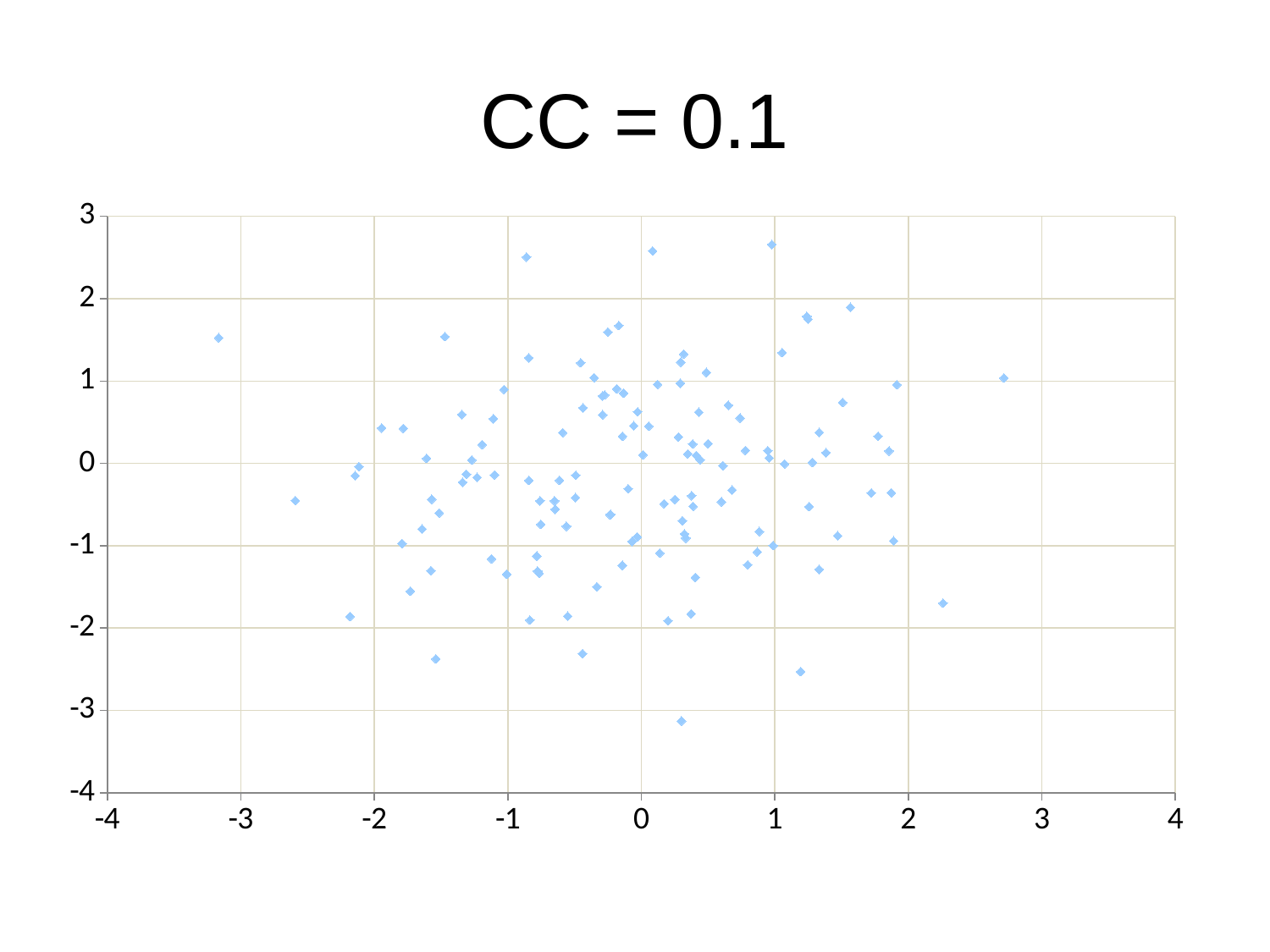
What is the highest value labelled on the y axis? 3 What kind of chart is shown on the slide? scatter chart Is the x value of the leftmost point on the chart greater or less than -3? less Is the x value of the rightmost point on the chart greater or less than 2? greater Is the y value of the lowest point on the chart greater or less than -3? less What is the title of the chart? CC = 0.1